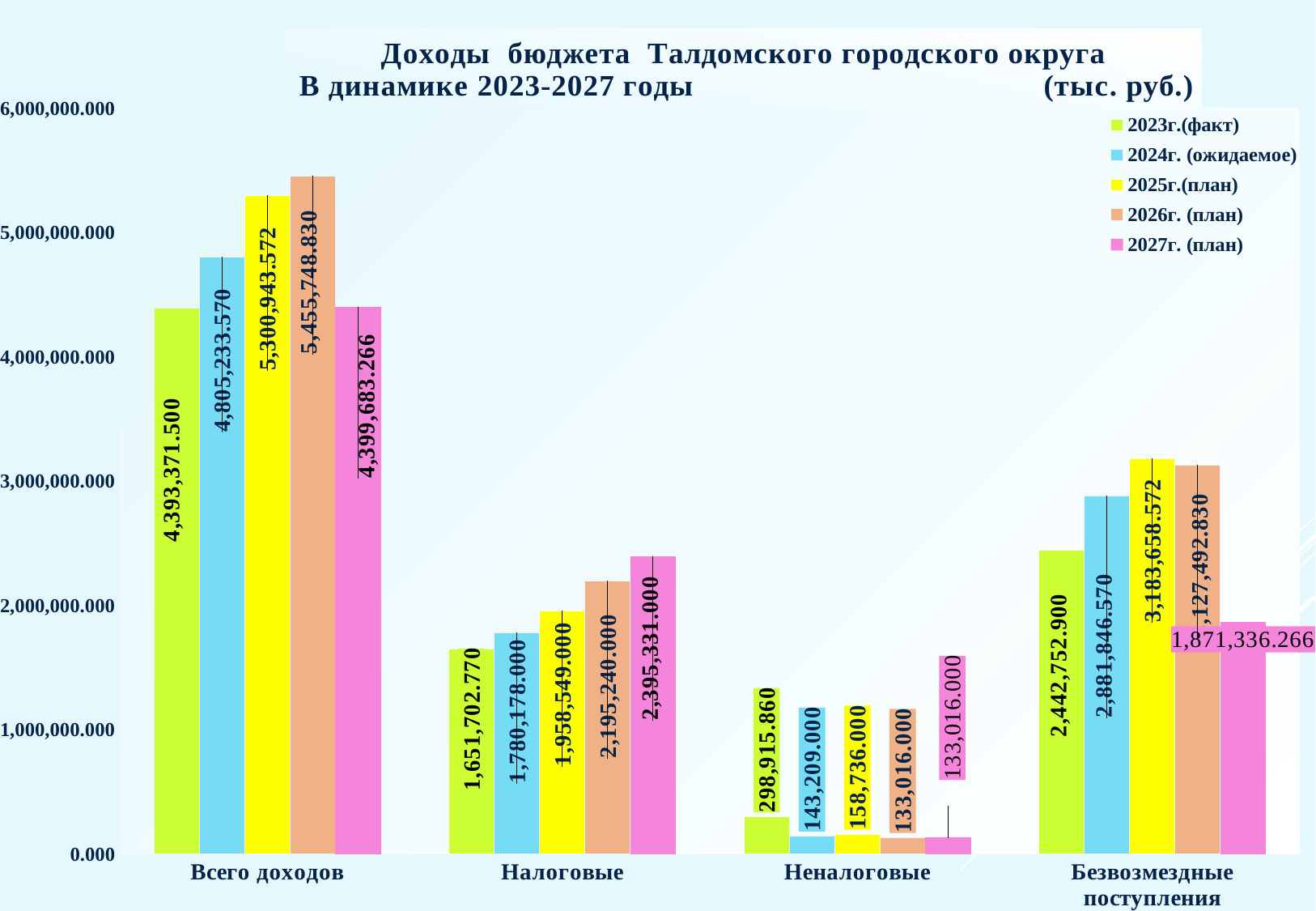
Is the value for 2023г.(факт) in the Неналоговые category greater or less than 1,000,000.000? less What is the difference between the 2027г. (план) and 2023г.(факт) values in the Налоговые category? 743,628.230 How many series does the legend list? 5 What is the value for 2027г. (план) in the Налоговые category? 2,395,331.000 Do the values in the Налоговые category rise or fall from 2023 to 2027? rise Which year has the highest value in the Всего доходов category? 2026г. (план) What kind of chart is shown on the slide? bar chart How many categories are shown on the x axis? 4 In the Безвозмездные поступления category, which is larger: the 2025г.(план) value or the 2026г. (план) value? 2025г.(план) What is the value for 2026г. (план) in the Всего доходов category? 5,455,748.830 Which year has the lowest value in the Безвозмездные поступления category? 2027г. (план) What is the value for 2024г. (ожидаемое) in the Безвозмездные поступления category? 2,881,846.570